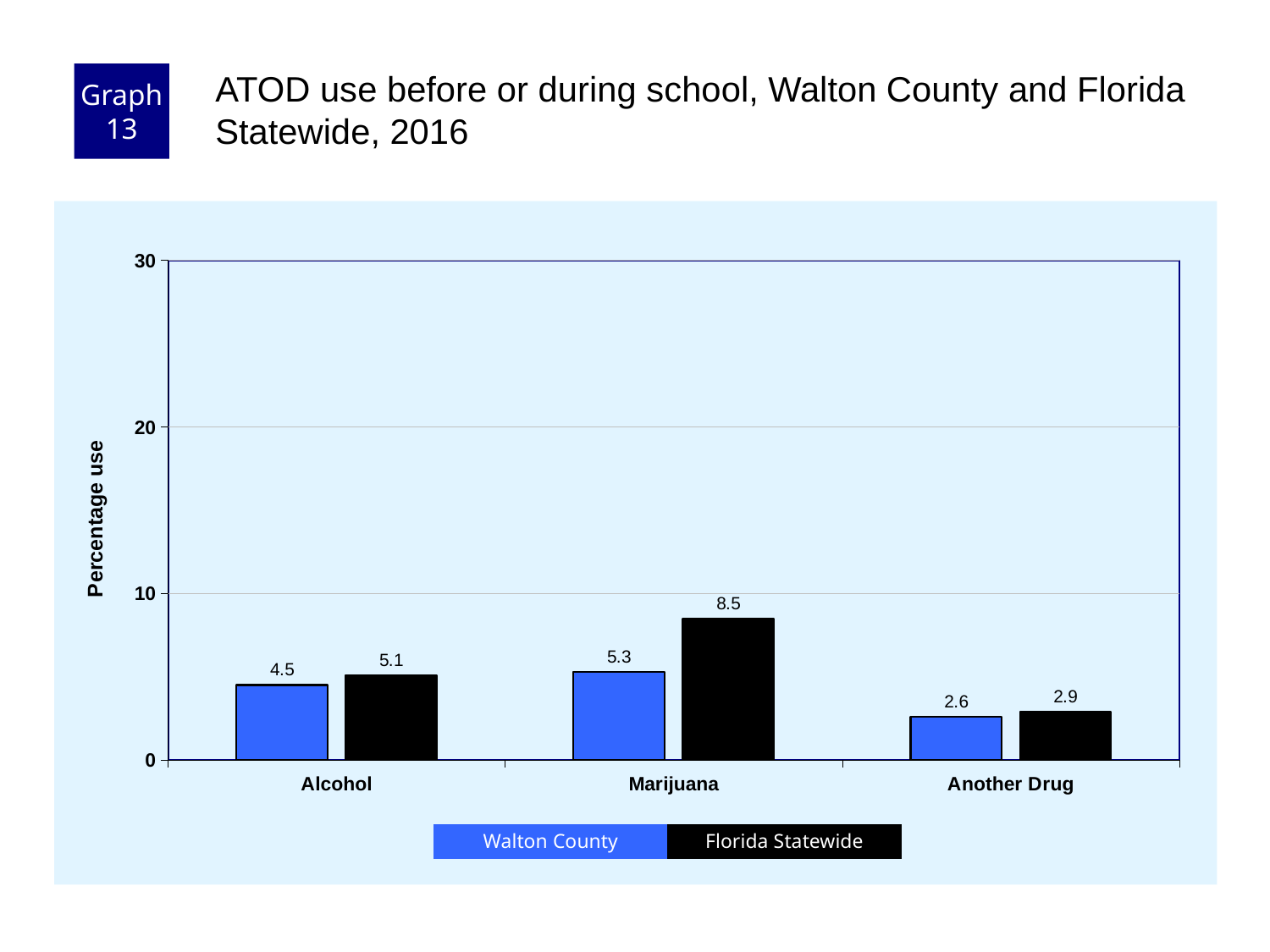
Which is larger for Another Drug, Walton County or Florida Statewide? Florida Statewide How many series does the legend list? 2 Which category has the lowest Walton County value? Another Drug What is the Walton County value for Another Drug? 2.6 What is the difference between the Florida Statewide and Walton County values for Marijuana? 3.2 Is the Florida Statewide value for Marijuana greater or less than 10? less What is the Florida Statewide value for Marijuana? 8.5 Which category has the highest Florida Statewide value? Marijuana What is the Florida Statewide value for Alcohol? 5.1 How many categories are shown on the x axis? 3 What kind of chart is shown on the slide? bar chart What is the Walton County value for Alcohol? 4.5